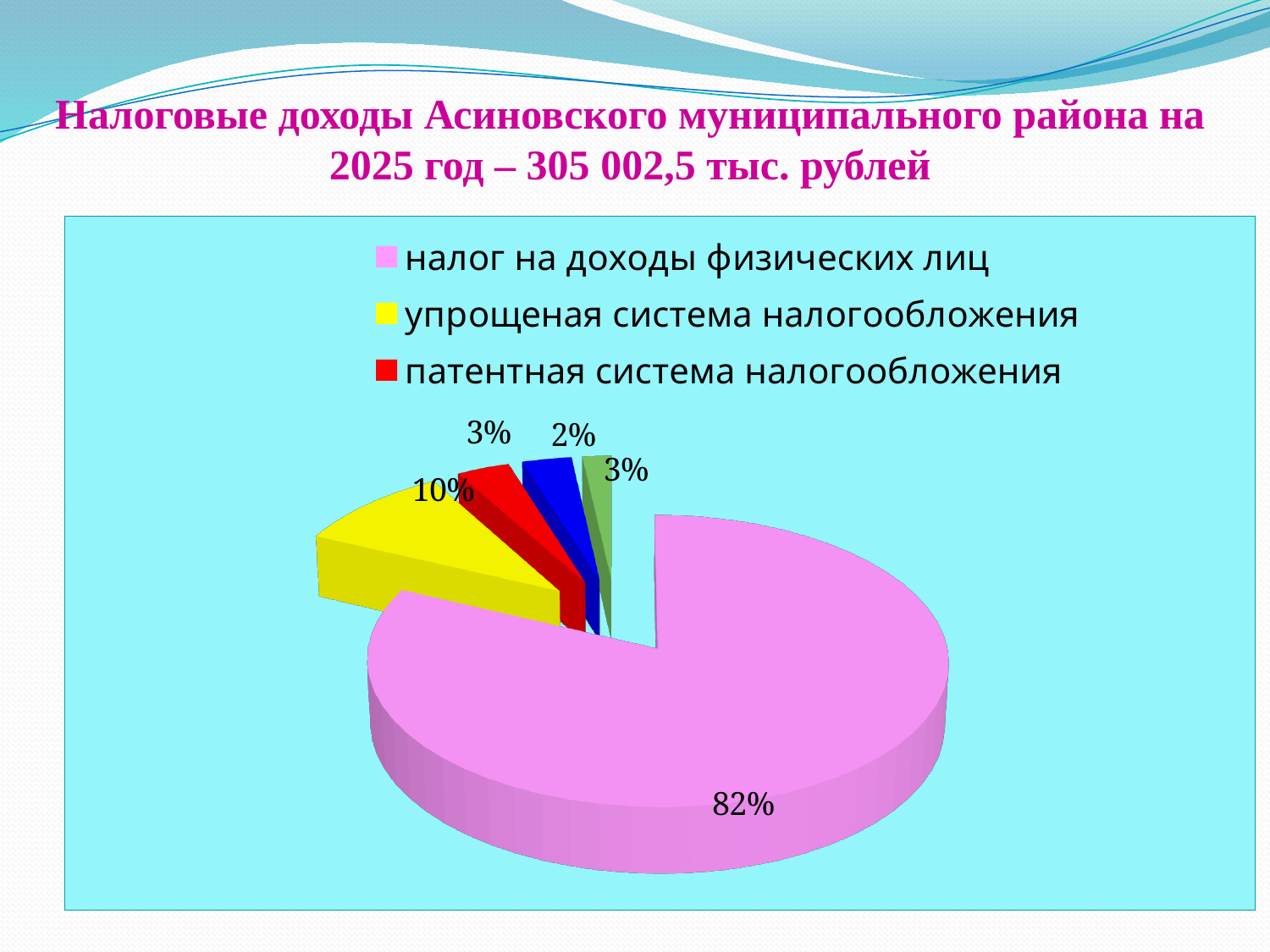
How many slices does the pie chart have? 5 How many entries does the legend list? 3 According to the slide title, what is the total tax revenue of the Asinovsky municipal district for 2025? 305 002,5 тыс. рублей What is the smallest percentage printed on the pie chart? 2% Which is larger: the share for упрощеная система налогообложения or the share for патентная система налогообложения? упрощеная система налогообложения Which category has the largest slice of the pie? налог на доходы физических лиц What share of the pie is labelled for налог на доходы физических лиц? 82% By how many percentage points does the share for налог на доходы физических лиц exceed the share for упрощеная система налогообложения? 72 percentage points What share of the pie is labelled for патентная система налогообложения? 3% What share of the pie is labelled for упрощеная система налогообложения? 10% What kind of chart is shown on the slide? pie chart What colour is the slice for налог на доходы физических лиц? pink